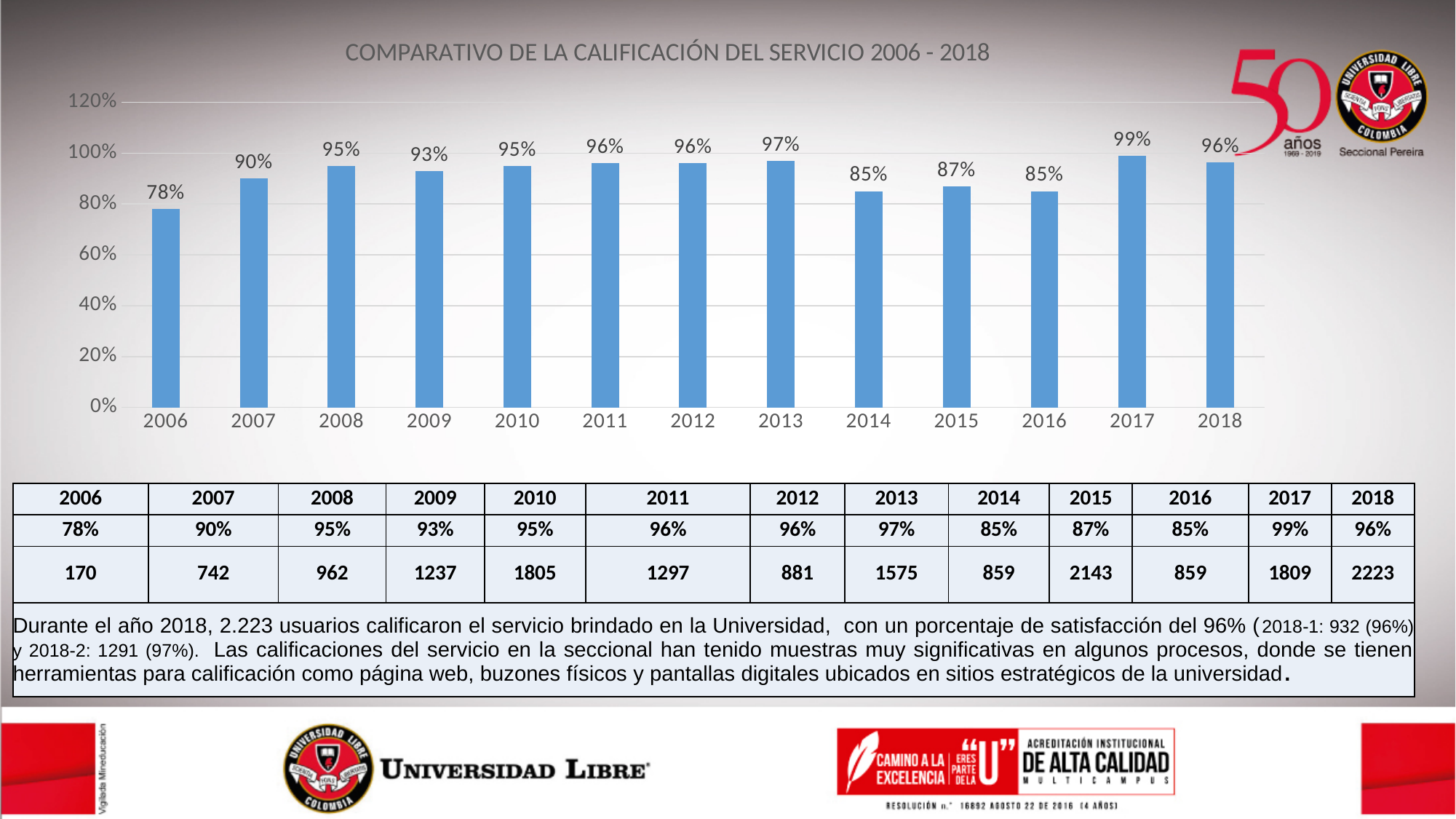
Which is larger, the value for 2014 or the value for 2015? 2015 Is the value for 2009 greater or less than 80%? greater What is the value for 2013? 97% Which year has the highest value? 2017 Which year has the lowest value? 2006 How many years are shown on the x axis? 13 What kind of chart is shown? bar chart Do the values rise or fall from 2006 to 2008? rise What is the difference between the values for 2017 and 2006? 21% What is the value for 2006? 78% What is the title of the chart? COMPARATIVO DE LA CALIFICACIÓN DEL SERVICIO 2006 - 2018 What is the value for 2017? 99%